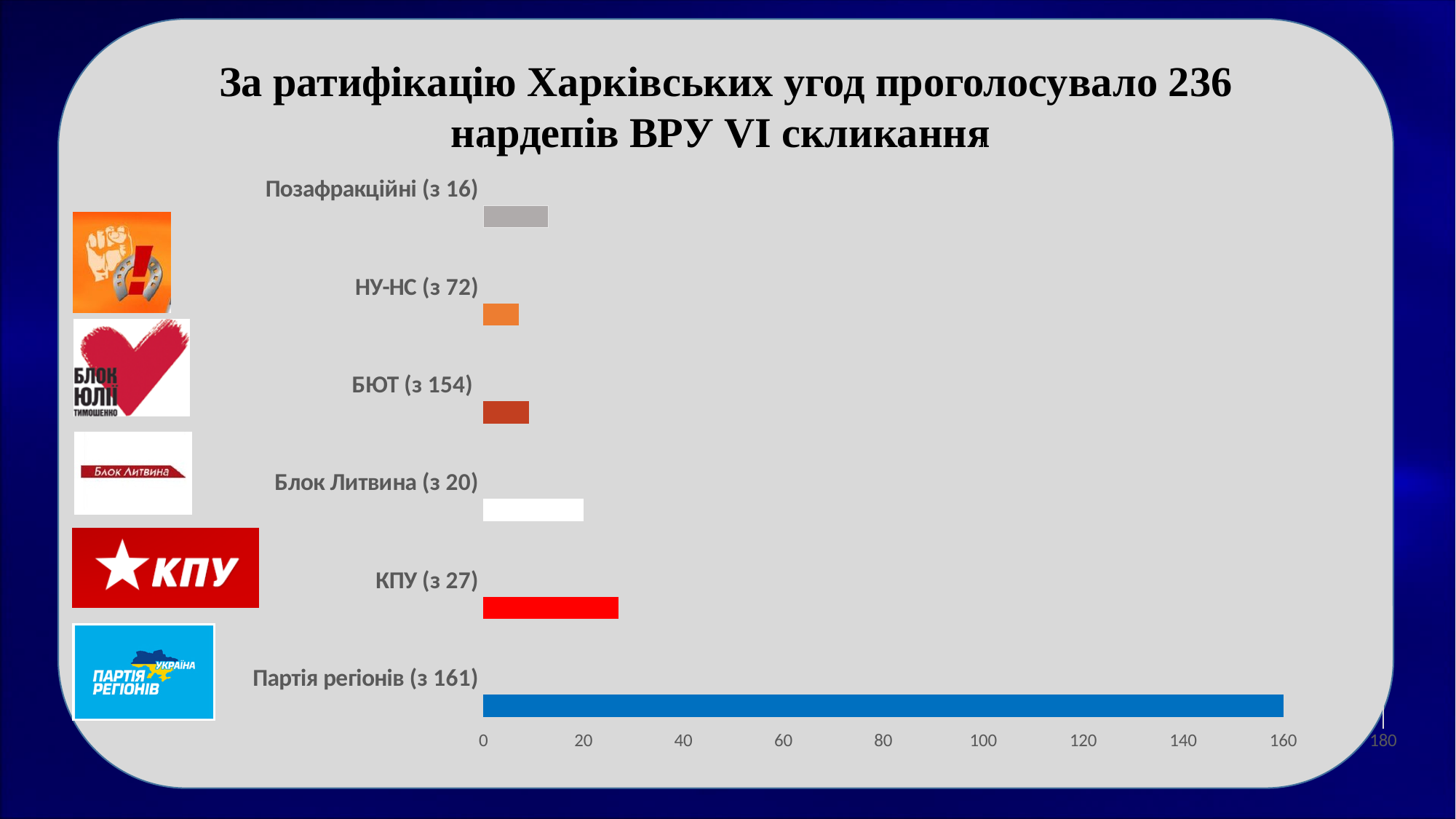
According to the slide title, how many deputies voted for ratification of the Kharkiv agreements? 236 Is the value for КПУ (з 27) greater or less than 20? greater Which faction has the highest value in the chart? Партія регіонів (з 161) Which is larger, the value for КПУ (з 27) or the value for Блок Литвина (з 20)? КПУ (з 27) Is the value for БЮТ (з 154) greater or less than 40? less Which is larger, the value for Партія регіонів (з 161) or the value for КПУ (з 27)? Партія регіонів (з 161) Is the value for Позафракційні (з 16) greater or less than 20? less How many categories (factions) are plotted in the chart? 6 What is the highest tick value shown on the horizontal axis? 180 What kind of chart is shown on the slide? bar chart